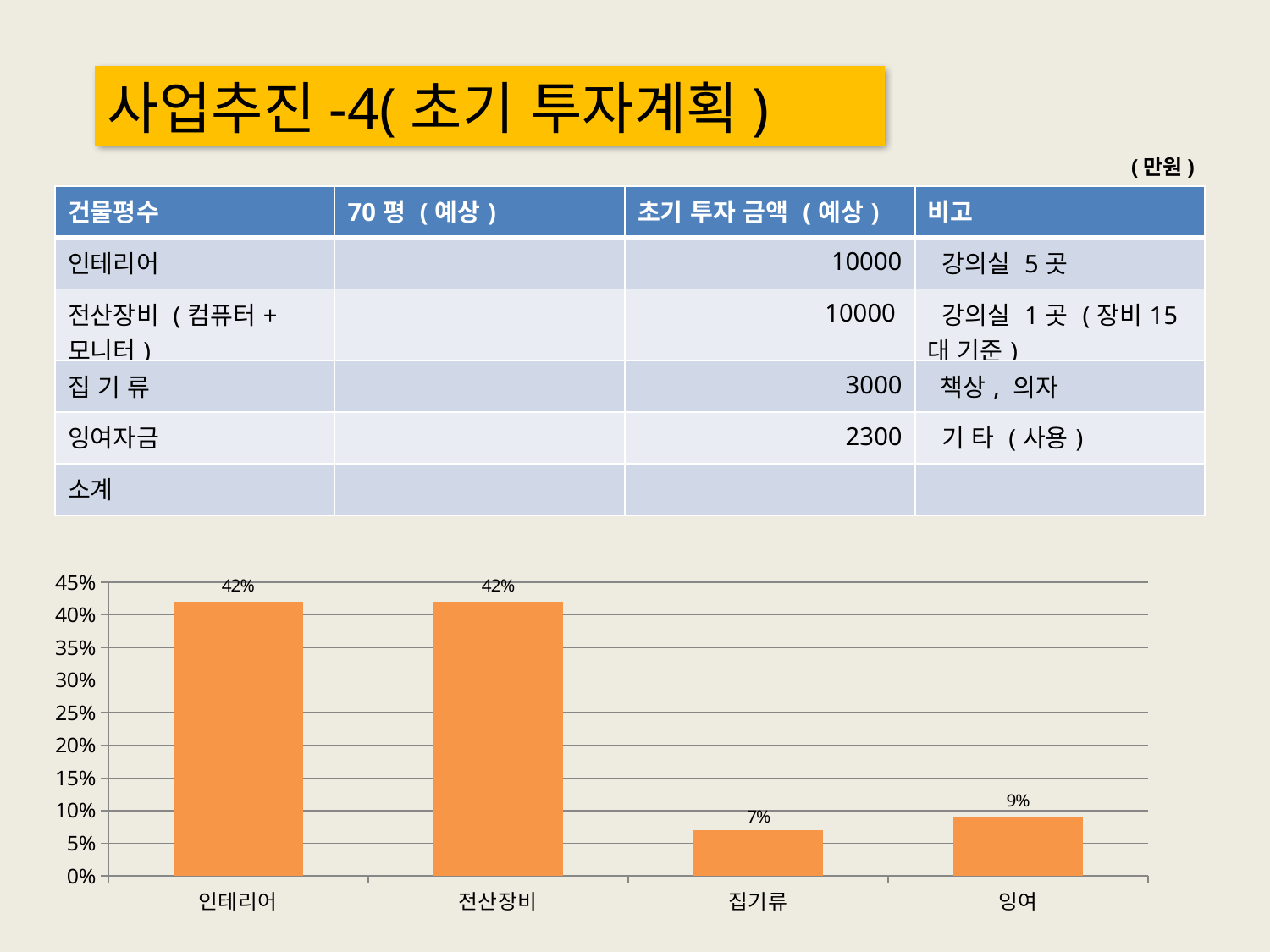
Is the value for 전산장비 in the bar chart greater or less than 40%? greater What is the value for 인테리어 in the bar chart? 42% Which is larger in the bar chart, the value for 잉여 or the value for 집기류? 잉여 Which category has the lowest value in the bar chart? 집기류 What is the difference between the values for 잉여 and 집기류 in the bar chart? 2% What is the value for 잉여 in the bar chart? 9% What is the difference between the values for 인테리어 and 잉여 in the bar chart? 33% What is the value for 전산장비 in the bar chart? 42% What kind of chart is shown on the slide? bar chart What is the value for 집기류 in the bar chart? 7% Is the value for 집기류 in the bar chart greater or less than 10%? less How many categories are shown in the bar chart? 4